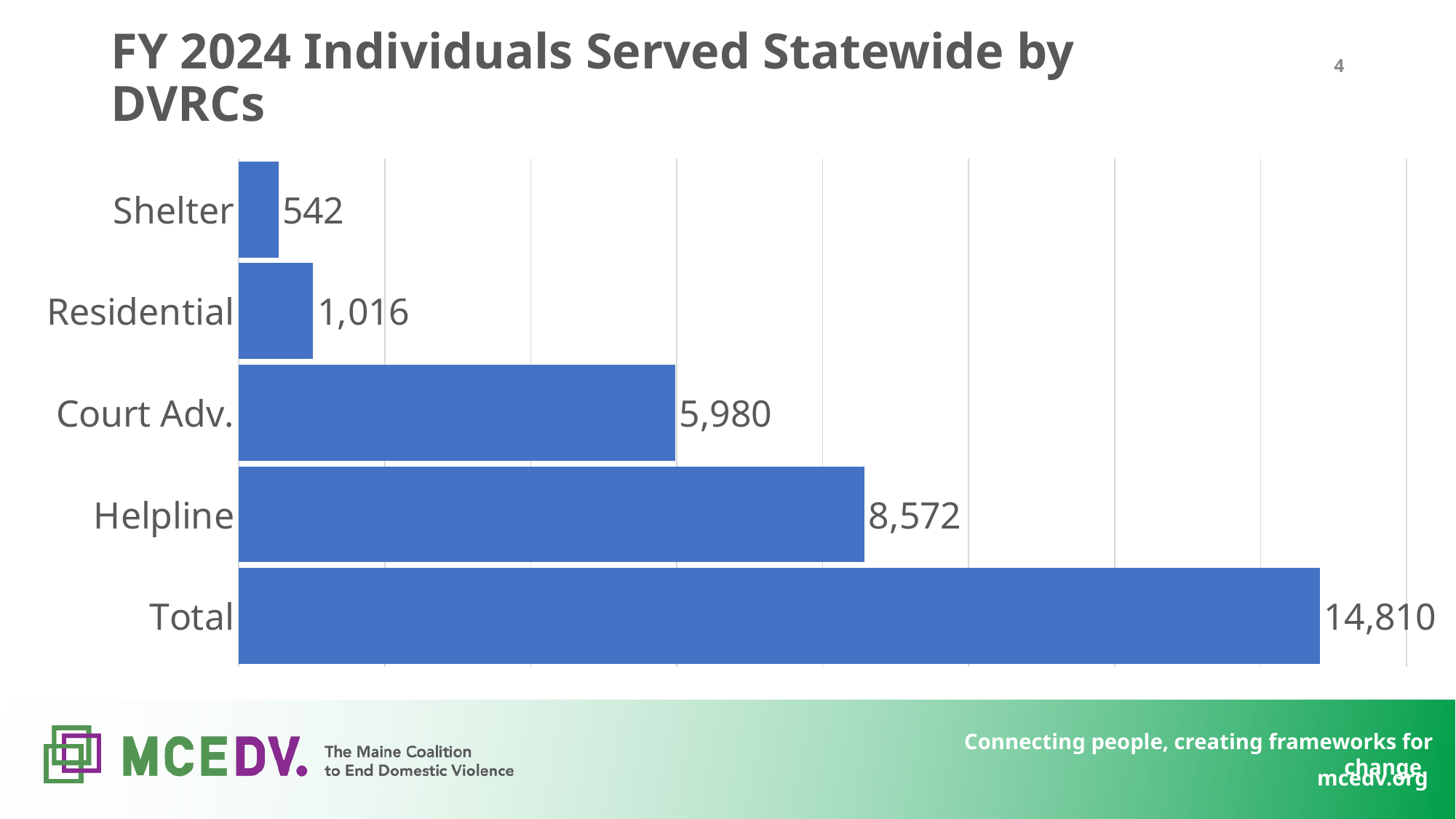
What is the value for Court Adv.? 5,980 Which category has the highest value? Total How many categories are shown in the chart? 5 What is the value for Shelter? 542 What is the value for Helpline? 8,572 What kind of chart is shown on the slide? Bar chart What is the difference between the Residential and Shelter values? 474 Which category has the lowest value? Shelter What is the value for Total? 14,810 Which is larger, the value for Court Adv. or the value for Helpline? Helpline What is the difference between the Helpline and Court Adv. values? 2,592 What is the value for Residential? 1,016